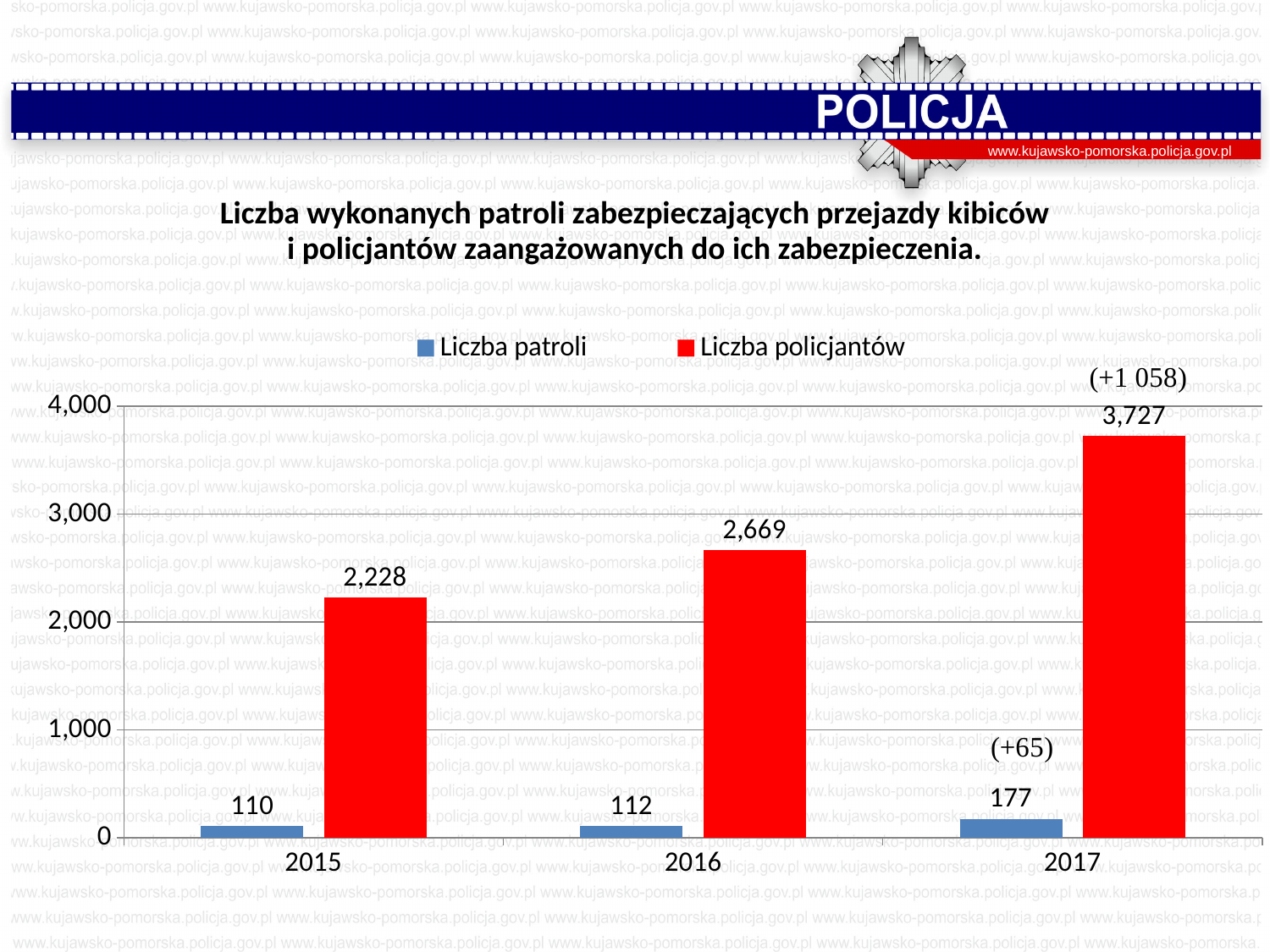
What is the value of Liczba policjantów for 2016? 2,669 What is the value of Liczba patroli for 2017? 177 Which year has the lowest value for Liczba patroli? 2015 What is the value of Liczba policjantów for 2017? 3,727 What is the difference between Liczba policjantów in 2017 and in 2016? 1,058 Which is larger: Liczba policjantów in 2015 or in 2016? 2016 What is the difference between Liczba patroli in 2017 and in 2016? 65 What is the value of Liczba patroli for 2015? 110 Which year has the highest value for Liczba policjantów? 2017 How many years are shown on the x axis? 3 Does Liczba policjantów rise or fall from 2015 to 2017? rise How many series does the legend list? 2